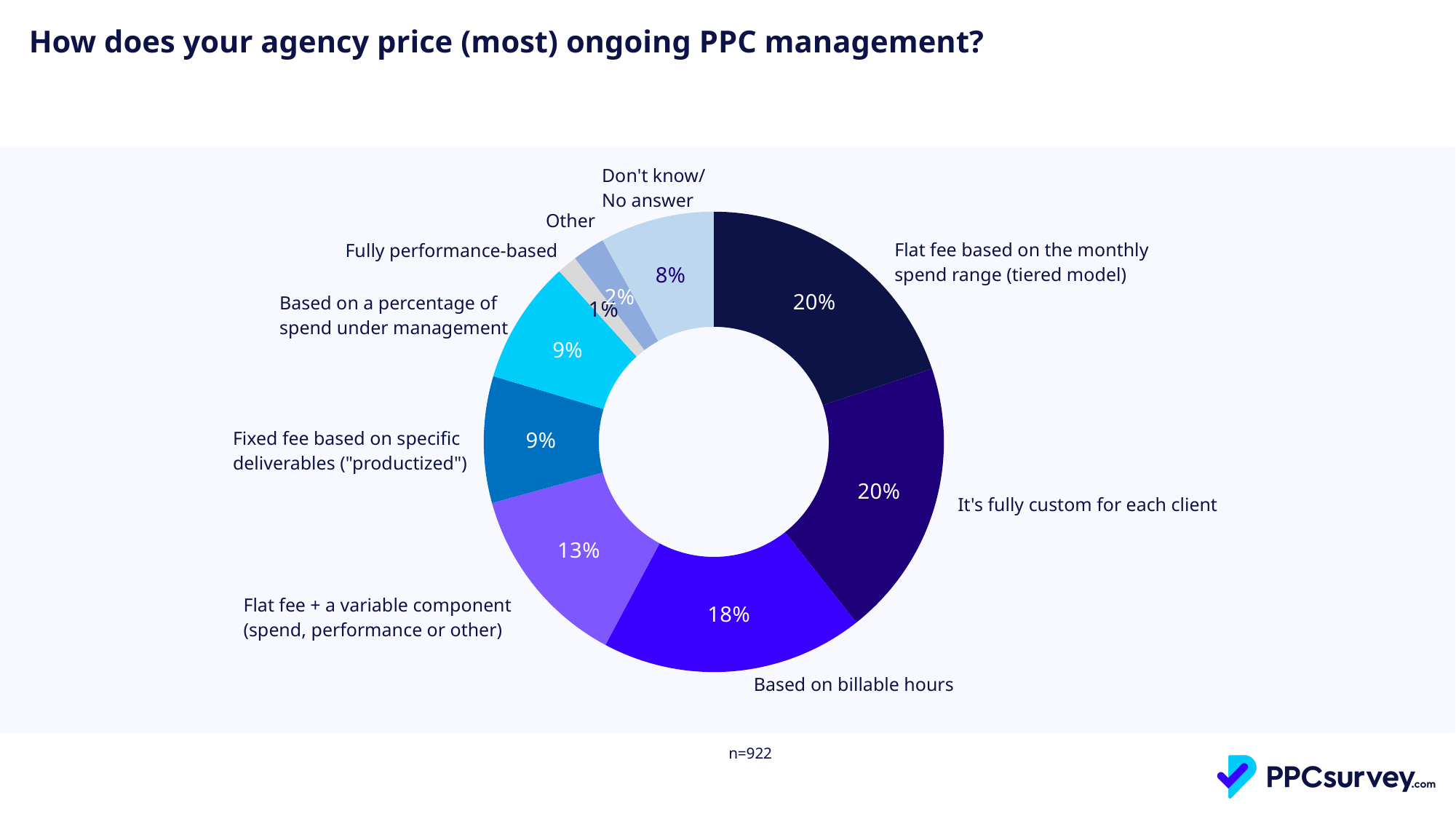
What is the difference in percentage points between 'It's fully custom for each client' and 'Based on billable hours'? 2 percentage points How many slices does the pie chart have? 9 What kind of chart is shown on the slide? Doughnut chart What percentage answered 'Don't know/No answer'? 8% What is the value for 'Other'? 2% What share of the pie is 'Flat fee + a variable component (spend, performance or other)'? 13% Which is larger: 'Based on billable hours' or 'Flat fee + a variable component'? Based on billable hours Which pricing approach has the smallest slice of the pie? Fully performance-based What is the sample size (n) shown below the chart? n=922 What percentage of agencies price ongoing PPC management based on billable hours? 18% What is the value for 'Flat fee based on the monthly spend range (tiered model)'? 20% What is the value for 'Fixed fee based on specific deliverables ("productized")'? 9%